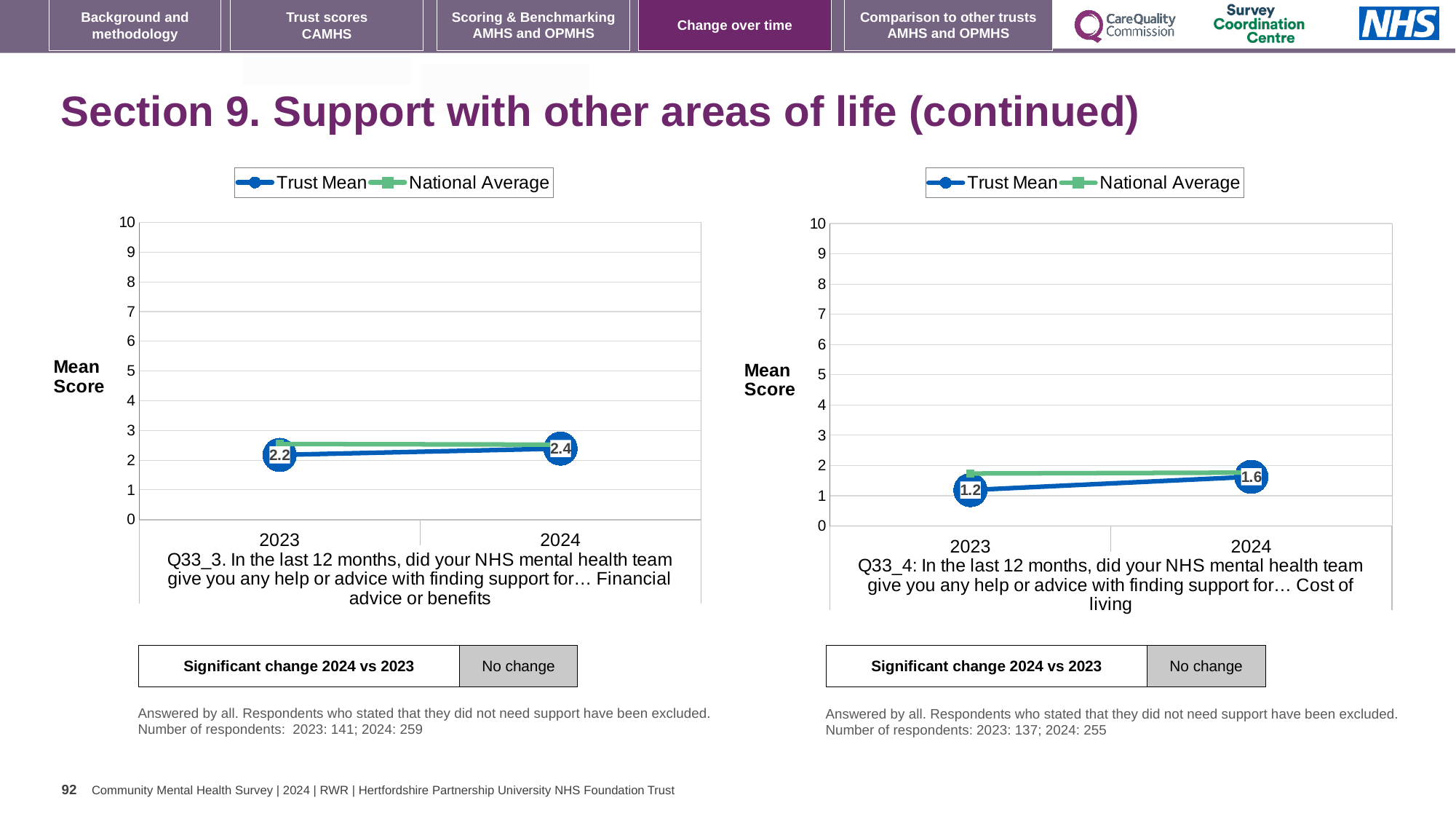
In the right chart (Q33_4), does the Trust Mean rise or fall from 2023 to 2024? rise In the right chart (Q33_4), what is the difference between the Trust Mean for 2024 and 2023? 0.4 In the left chart (Q33_3, Financial advice or benefits), what is the Trust Mean for 2023? 2.2 In the right chart (Q33_4, Cost of living), what is the Trust Mean for 2023? 1.2 In the right chart (Q33_4), is the National Average for 2023 greater or less than 1? greater In the left chart (Q33_3), is the National Average for 2024 greater or less than 3? less In the left chart (Q33_3), which year has the higher Trust Mean, 2023 or 2024? 2024 In the left chart (Q33_3), by how much did the Trust Mean change from 2023 to 2024? 0.2 How many series does the legend of the left chart list? 2 In the right chart (Q33_4, Cost of living), what is the Trust Mean for 2024? 1.6 What type of chart is the right chart (Q33_4, Cost of living)? line chart In the left chart (Q33_3, Financial advice or benefits), what is the Trust Mean for 2024? 2.4